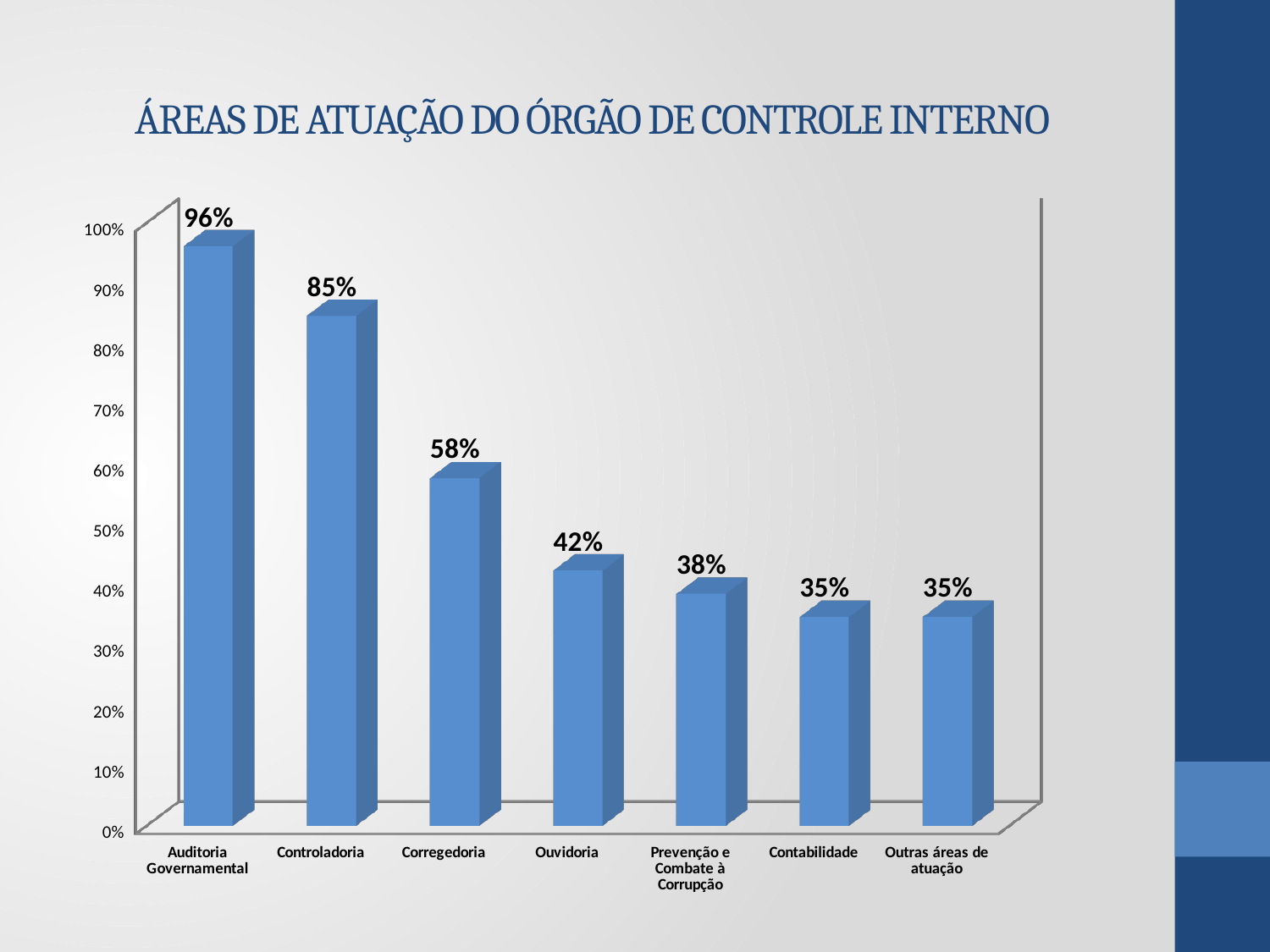
How many categories are shown on the chart? 7 What is the difference between the values for Auditoria Governamental and Controladoria? 11% Which category has the highest value? Auditoria Governamental What is the value for Corregedoria? 58% What is the title of the chart? ÁREAS DE ATUAÇÃO DO ÓRGÃO DE CONTROLE INTERNO What is the difference between the values for Controladoria and Ouvidoria? 43% Which two categories share the same value of 35%? Contabilidade and Outras áreas de atuação Which is larger, the value for Corregedoria or the value for Ouvidoria? Corregedoria What kind of chart is shown on the slide? Bar chart Do the values rise or fall from left to right along the x axis? Fall What is the value for Auditoria Governamental? 96% What is the value for Prevenção e Combate à Corrupção? 38%